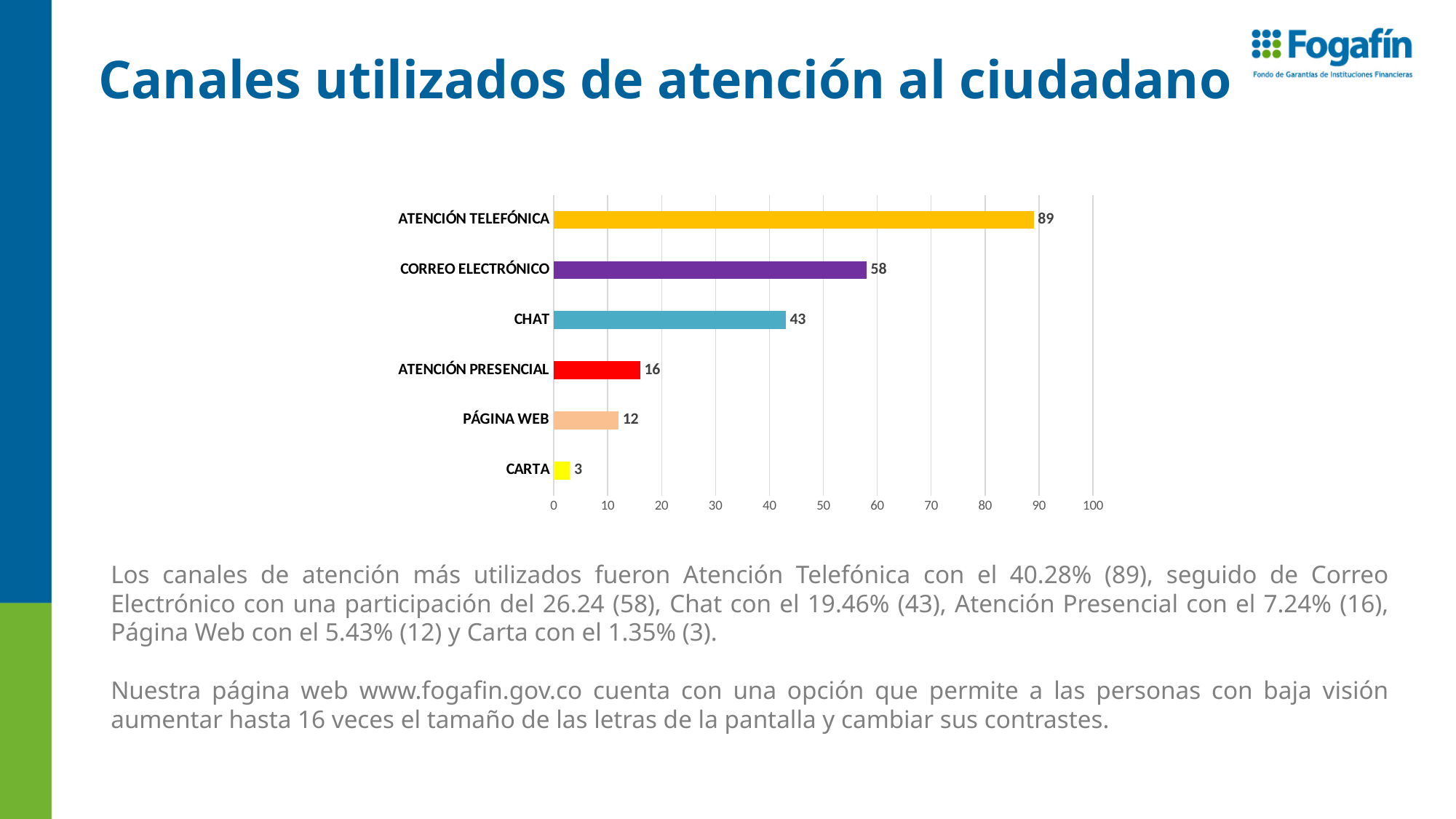
Which is larger, the value for CHAT or the value for ATENCIÓN PRESENCIAL? CHAT What is the difference between the values for ATENCIÓN PRESENCIAL and CARTA? 13 What is the value for CORREO ELECTRÓNICO? 58 What is the value for ATENCIÓN TELEFÓNICA? 89 What is the value for PÁGINA WEB? 12 What kind of chart is shown on the slide? Bar chart What is the difference between the values for ATENCIÓN TELEFÓNICA and CORREO ELECTRÓNICO? 31 What colour is the bar for ATENCIÓN PRESENCIAL? Red What is the value for CHAT? 43 How many categories are shown in the chart? 6 Which category has the highest value? ATENCIÓN TELEFÓNICA Which category has the lowest value? CARTA